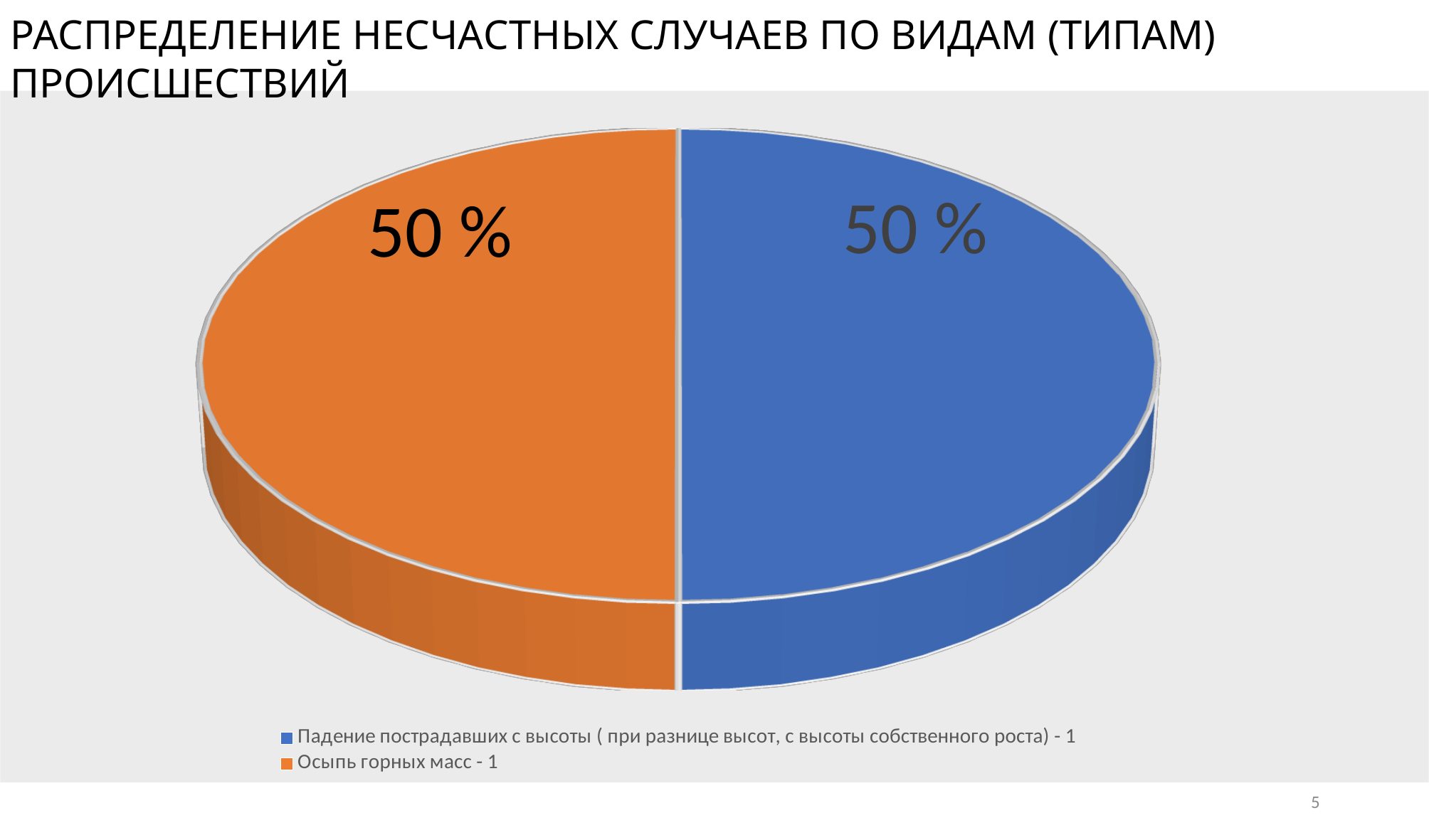
How many entries does the legend list? 2 Which colour is used for the slice "Падение пострадавших с высоты"? blue What share of the pie does the slice for "Падение пострадавших с высоты" represent? 50 % Which colour is used for the slice "Осыпь горных масс"? orange How many slices does the pie chart have? 2 What kind of chart is shown on the slide? pie chart What is the difference between the shares of the two slices? 0 % What is the total of the two slice percentages shown on the pie chart? 100 % What number is shown in the legend after "Падение пострадавших с высоты ( при разнице высот, с высоты собственного роста)"? 1 What share of the pie does the slice for "Осыпь горных масс" represent? 50 % What number is shown in the legend after "Осыпь горных масс"? 1